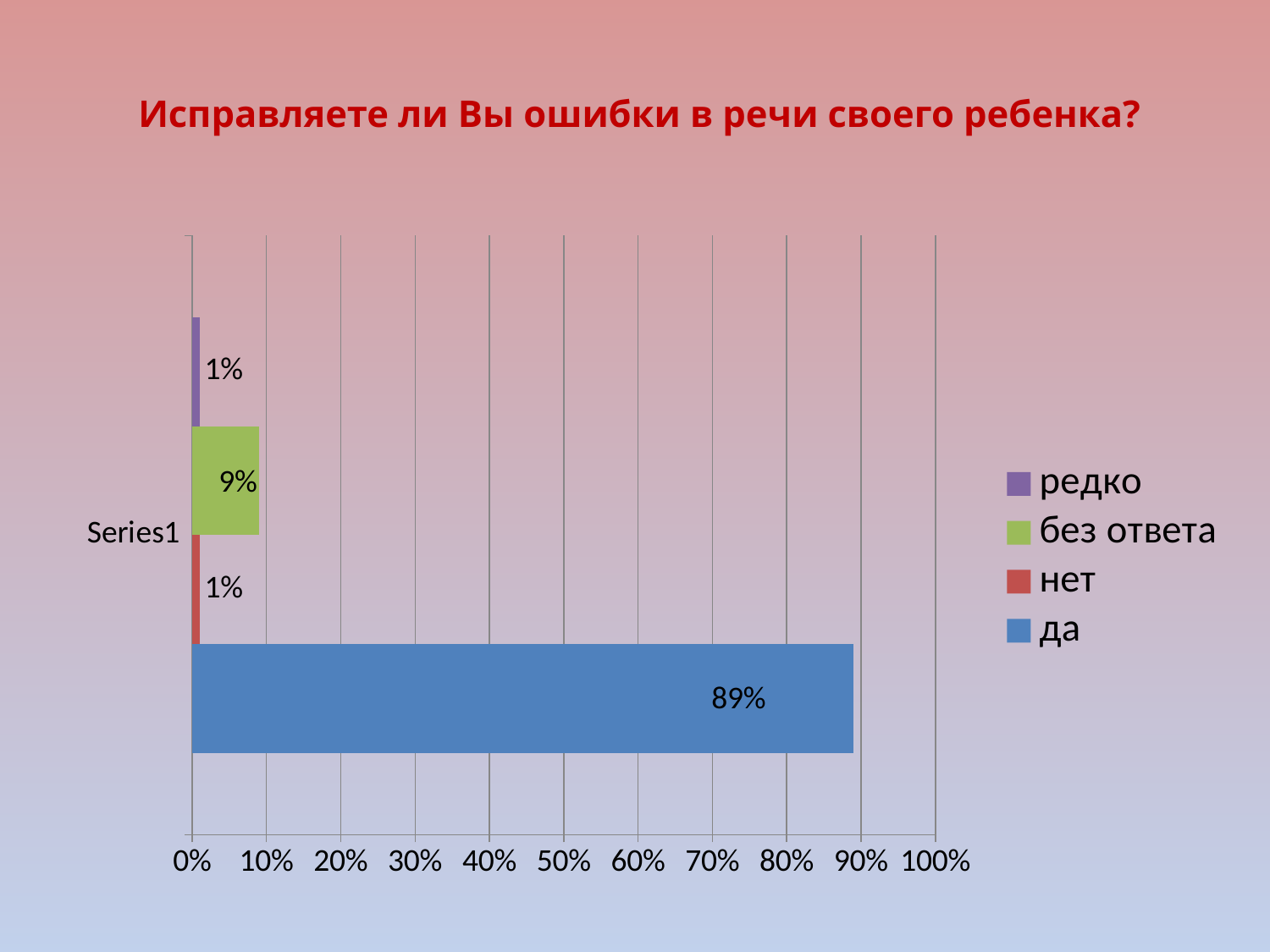
What is the title of the chart? Исправляете ли Вы ошибки в речи своего ребенка? What is the value for "редко"? 1% What is the value for "да"? 89% What is the value for "нет"? 1% What kind of chart is shown on the slide? bar chart Which series has the highest value? да Which is larger, the value for "без ответа" or the value for "нет"? без ответа What colour is the bar for "да"? blue Is the value for "да" greater or less than 80%? greater What is the value for "без ответа"? 9% What is the difference between the values for "да" and "без ответа"? 80% How many series does the legend list? 4